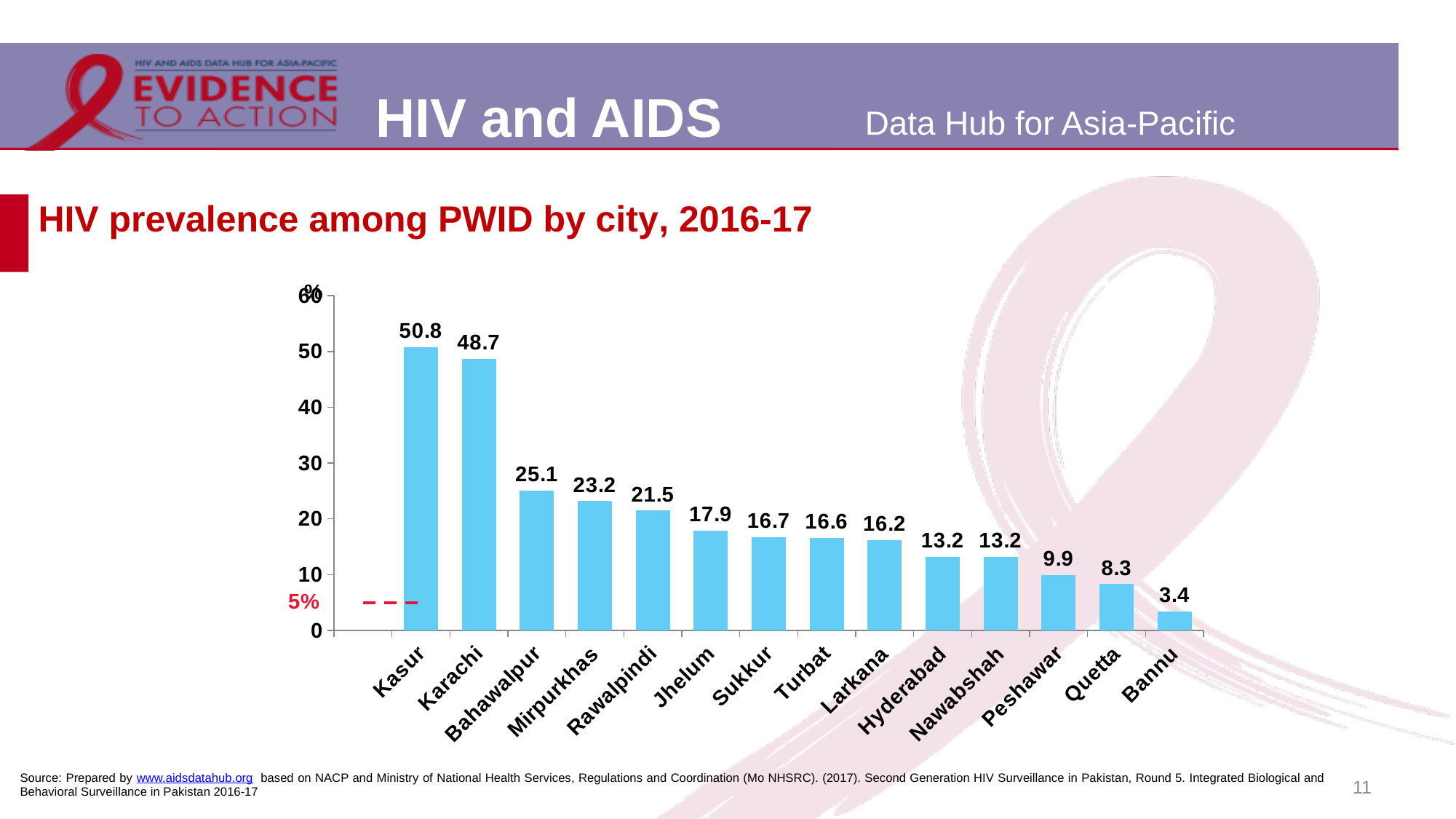
How many cities are shown in the chart? 14 Which city has the highest HIV prevalence among PWID? Kasur What kind of chart is used to show HIV prevalence among PWID by city? Bar chart What is the HIV prevalence among PWID in Rawalpindi? 21.5 What is the HIV prevalence among PWID in Peshawar? 9.9 Is the value for Mirpurkhas greater or less than 20? greater What is the difference in HIV prevalence between Bahawalpur and Quetta? 16.8 What reference level is marked by the red dashed line on the chart? 5% What is the difference in HIV prevalence between Kasur and Karachi? 2.1 Which city has a higher HIV prevalence among PWID, Jhelum or Larkana? Jhelum What is the HIV prevalence among PWID in Karachi? 48.7 Which city has the lowest HIV prevalence among PWID? Bannu